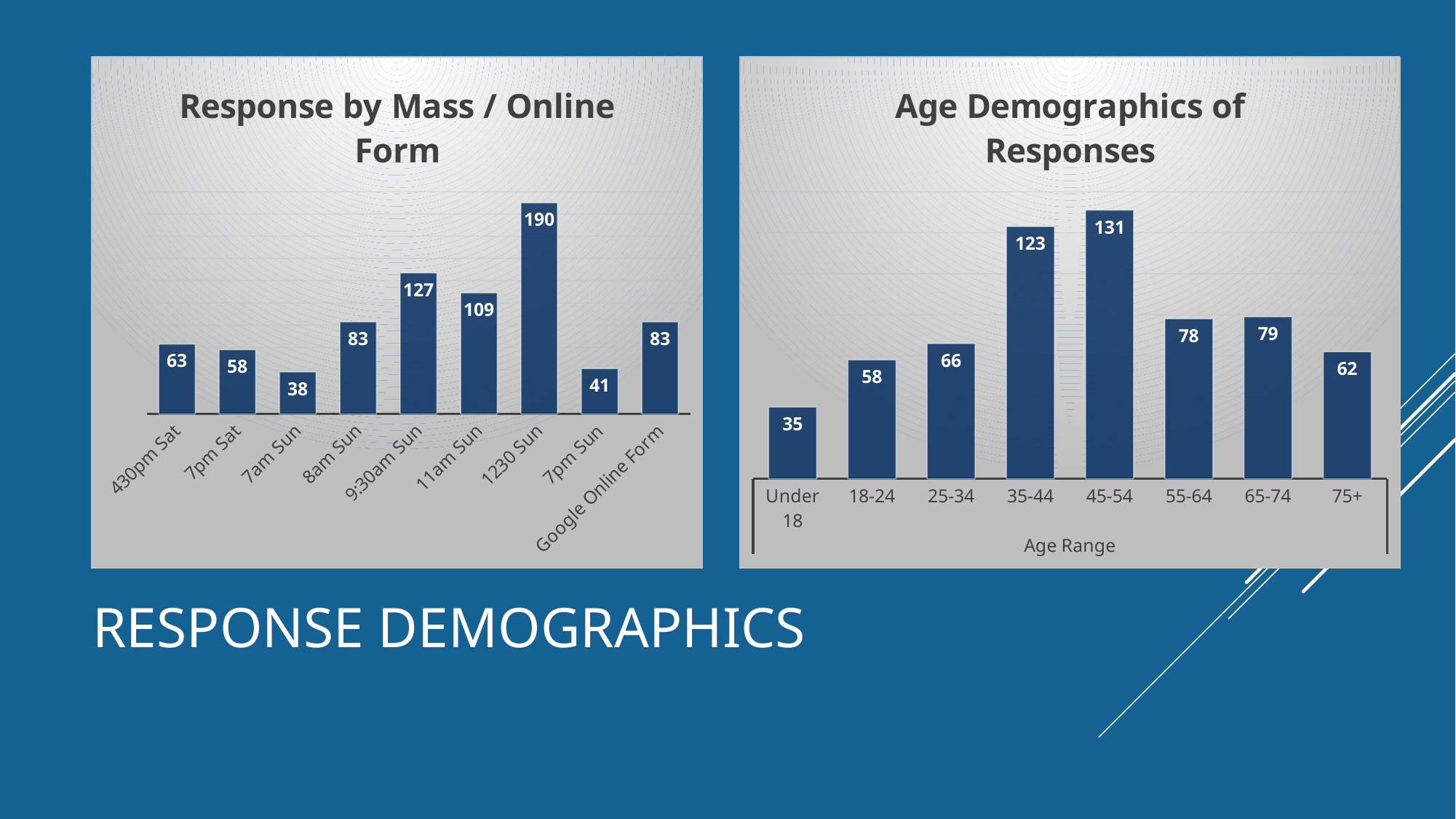
In the 'Response by Mass / Online Form' chart, which is larger, the value for 430pm Sat or the value for 7pm Sat? 430pm Sat In the 'Response by Mass / Online Form' chart, how many categories are shown? 9 In the 'Response by Mass / Online Form' chart, what is the difference between the values for 9:30am Sun and 11am Sun? 18 In the 'Age Demographics of Responses' chart, what is the value for 45-54? 131 What type of chart is the 'Age Demographics of Responses' chart? Bar chart What is the x-axis title of the 'Age Demographics of Responses' chart? Age Range In the 'Age Demographics of Responses' chart, which age range has the highest value? 45-54 In the 'Response by Mass / Online Form' chart, what is the value for 1230 Sun? 190 In the 'Age Demographics of Responses' chart, which age range has the lowest value? Under 18 In the 'Age Demographics of Responses' chart, what is the difference between the values for 35-44 and 25-34? 57 In the 'Response by Mass / Online Form' chart, which category has the lowest value? 7am Sun In the 'Response by Mass / Online Form' chart, what is the value for Google Online Form? 83